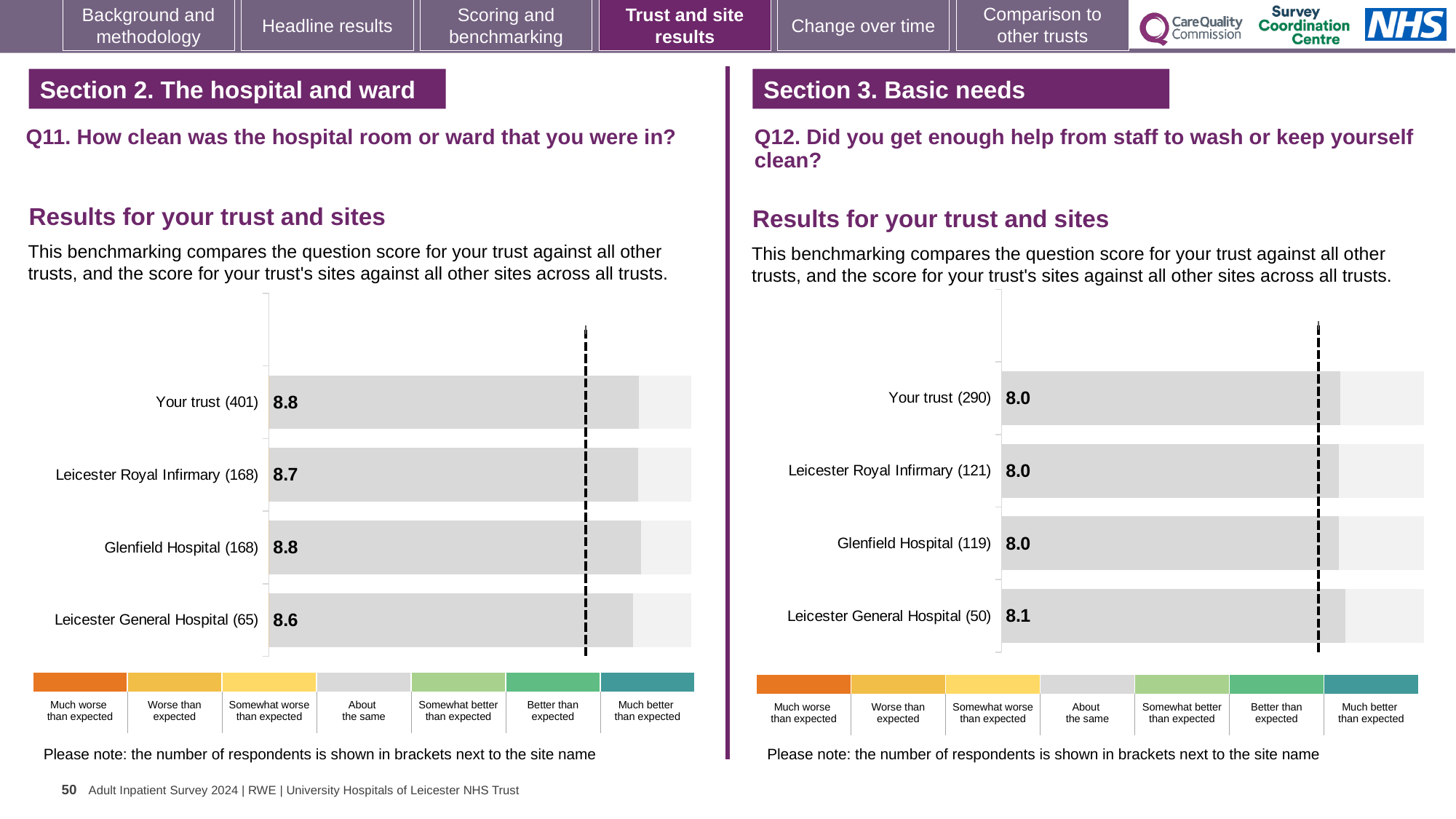
In the Q12 chart (right), which site has the highest score? Leicester General Hospital In the Q12 chart (right), what is the difference between the score for Leicester General Hospital and the score for Your trust? 0.1 In the Q11 chart (left), which site has the lowest score? Leicester General Hospital In the Q12 chart (right), what is the score for Leicester General Hospital? 8.1 In the Q11 chart (left), what is the score for Leicester Royal Infirmary? 8.7 In the Q11 chart (left), what is the score for Your trust? 8.8 How many bars are plotted in the Q12 chart (right)? 4 What kind of chart is the Q11 chart (left)? Bar chart In the Q11 chart (left), what is the difference between the score for Your trust and the score for Leicester General Hospital? 0.2 In the Q11 chart (left), which has the higher score, Glenfield Hospital or Leicester General Hospital? Glenfield Hospital In the Q12 chart (right), what is the score for Glenfield Hospital? 8.0 In the Q11 chart (left), how many respondents are shown in brackets for Your trust? 401